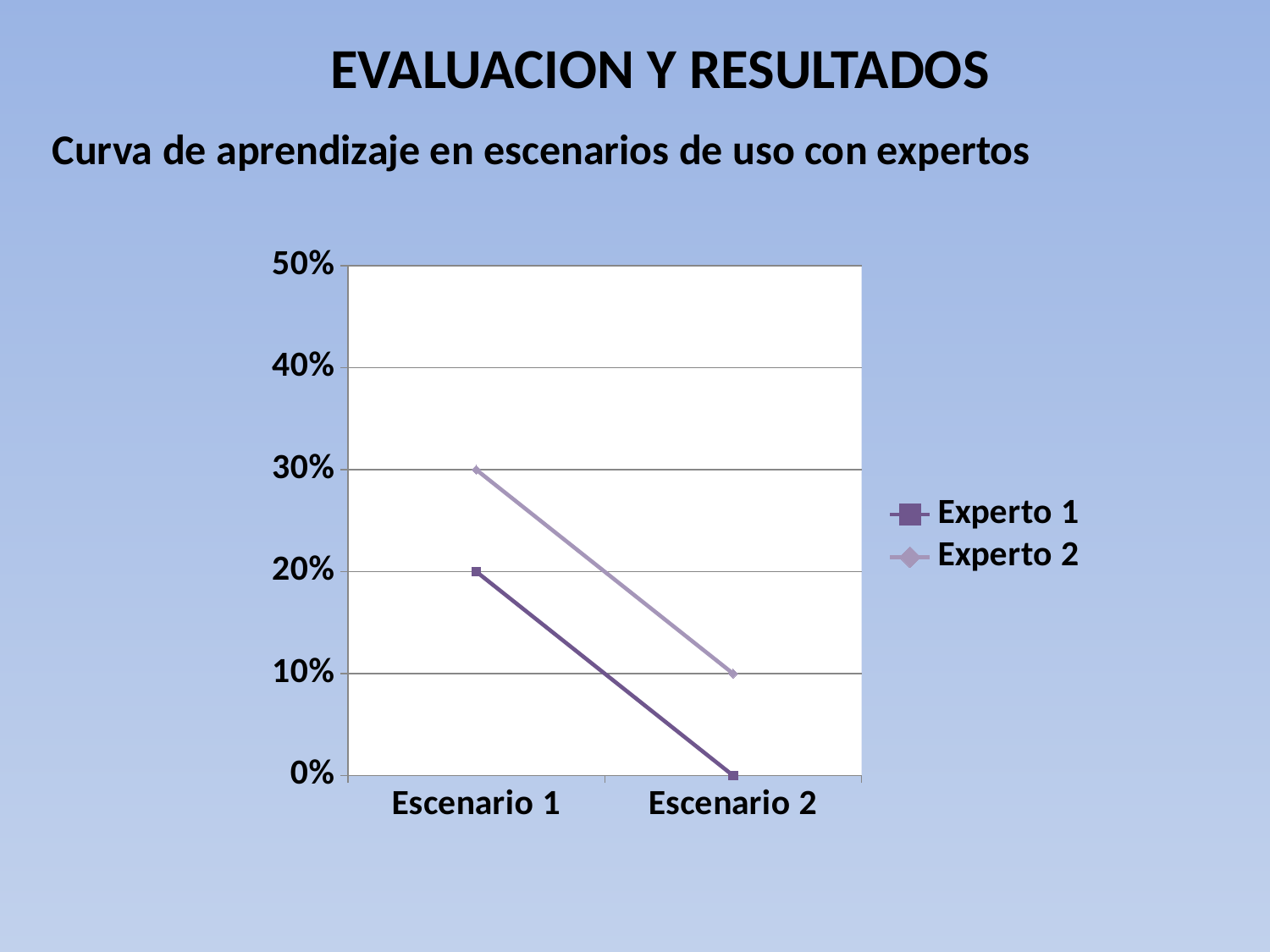
At which scenario does Experto 2 reach its lowest value? Escenario 2 What is the value for Experto 1 at Escenario 1? 20% What kind of chart is shown on the slide? line chart Which series has the higher value at Escenario 1, Experto 1 or Experto 2? Experto 2 What is the difference between Experto 2 and Experto 1 at Escenario 2? 10% What is the value for Experto 1 at Escenario 2? 0% Do the values for Experto 1 rise or fall from Escenario 1 to Escenario 2? fall What are the names of the two series in the legend? Experto 1 and Experto 2 How many categories are shown on the x axis? 2 What is the value for Experto 2 at Escenario 2? 10% How many series does the legend list? 2 What is the value for Experto 2 at Escenario 1? 30%